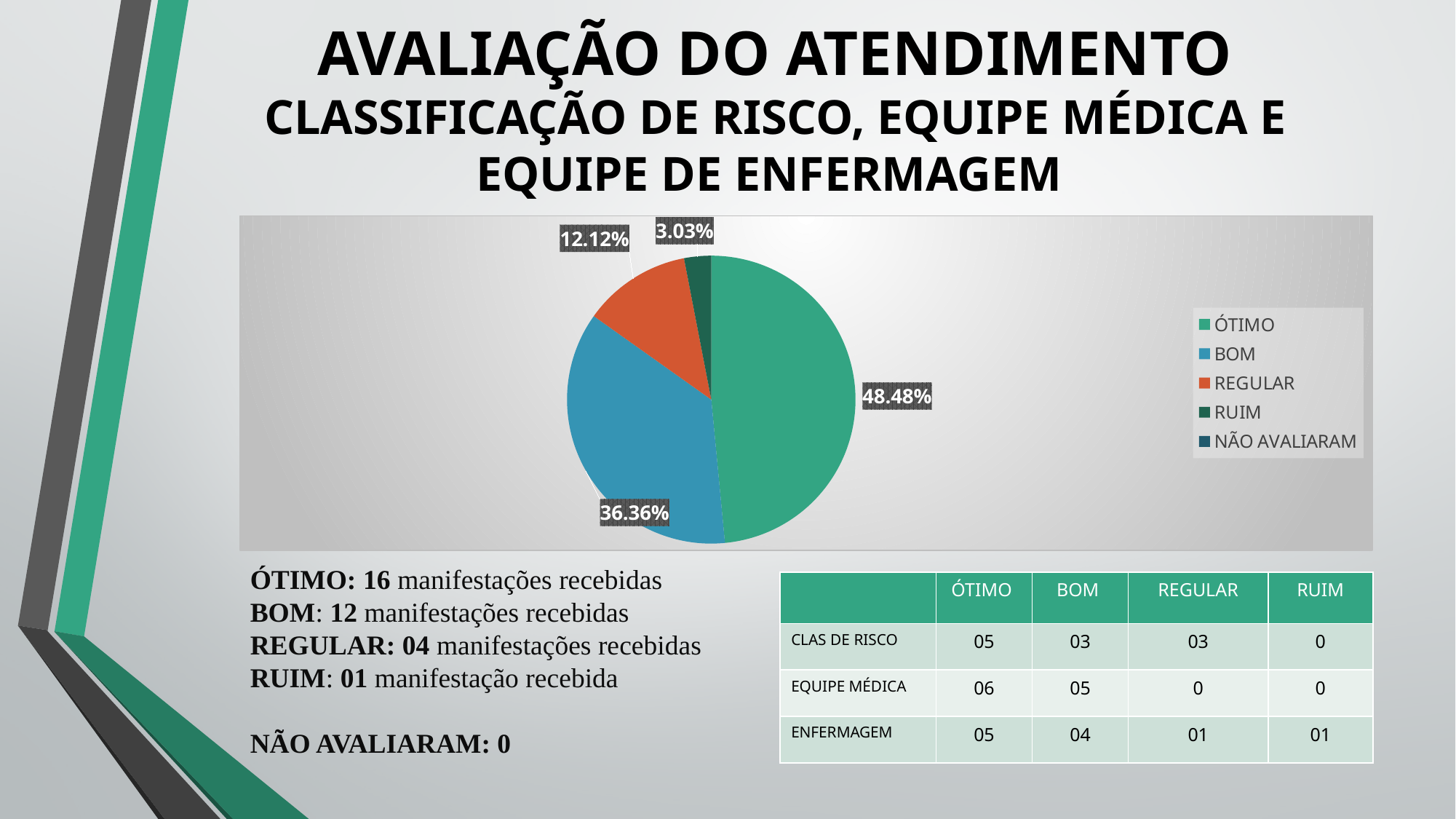
What colour is the ÓTIMO slice in the pie chart? green What share of the pie does BOM represent? 36.36% Which legend entry is listed last in the pie chart legend? NÃO AVALIARAM Which labelled slice of the pie is the smallest? RUIM What share of the pie does RUIM represent? 3.03% What is the difference in percentage points between the ÓTIMO and BOM slices? 12.12 Which category has the largest slice of the pie? ÓTIMO How many entries does the legend of the pie chart list? 5 What kind of chart is shown on the slide? pie chart What share of the pie does ÓTIMO represent? 48.48% What share of the pie does REGULAR represent? 12.12% Which slice is larger, REGULAR or RUIM? REGULAR